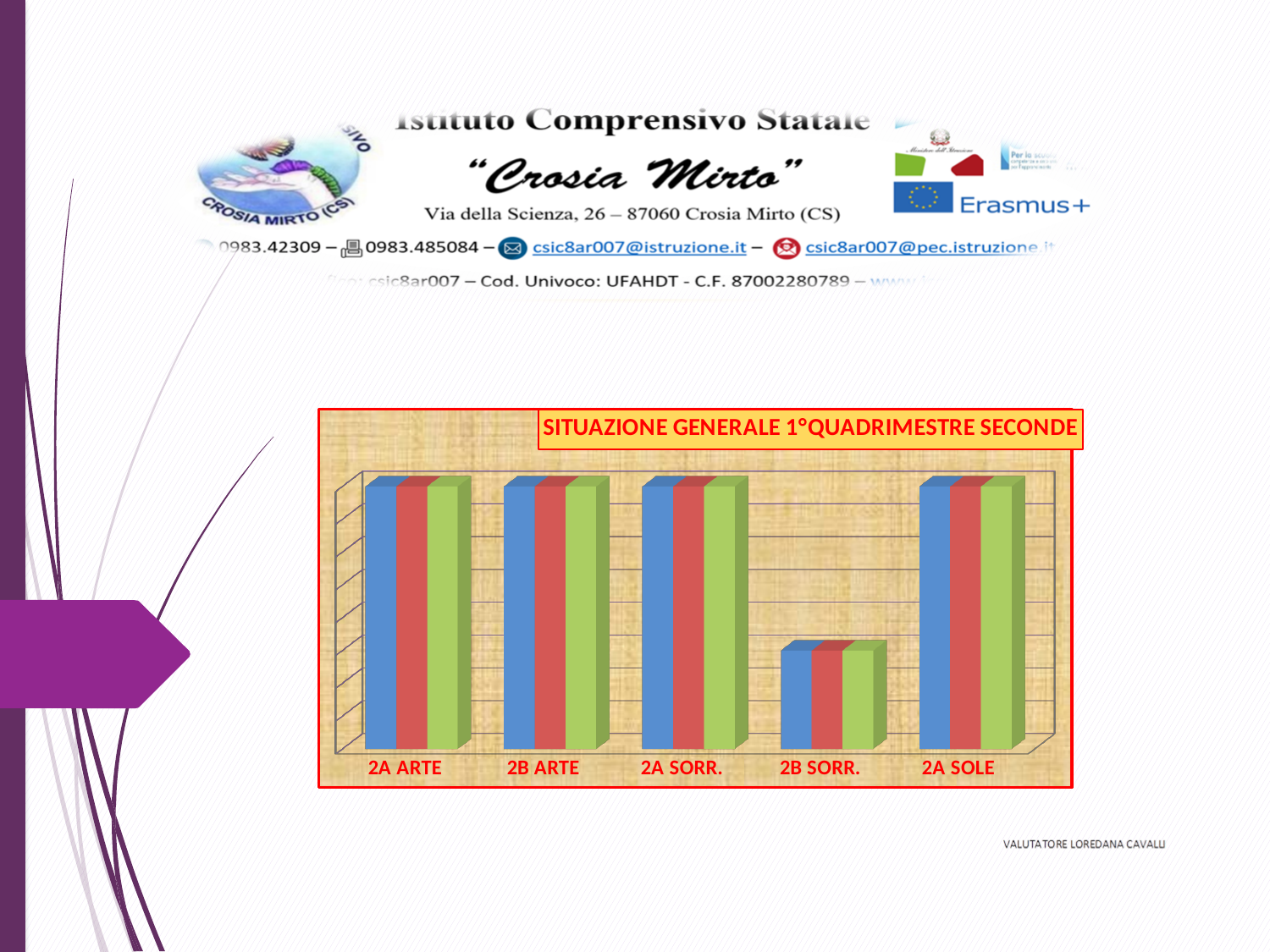
What is the title of the chart? SITUAZIONE GENERALE 1°QUADRIMESTRE SECONDE What kind of chart is shown on the slide? Bar chart How many categories are shown along the x axis of the chart? 5 Which category has the lowest bars in the chart? 2B SORR. Which category has higher bars, 2A ARTE or 2B SORR.? 2A ARTE What is the label of the last category on the x axis? 2A SOLE Which category has higher bars, 2B SORR. or 2A SOLE? 2A SOLE What is the label of the first category on the x axis? 2A ARTE Which category has higher bars, 2B SORR. or 2A SORR.? 2A SORR. How many bars are plotted for each category in the chart? 3